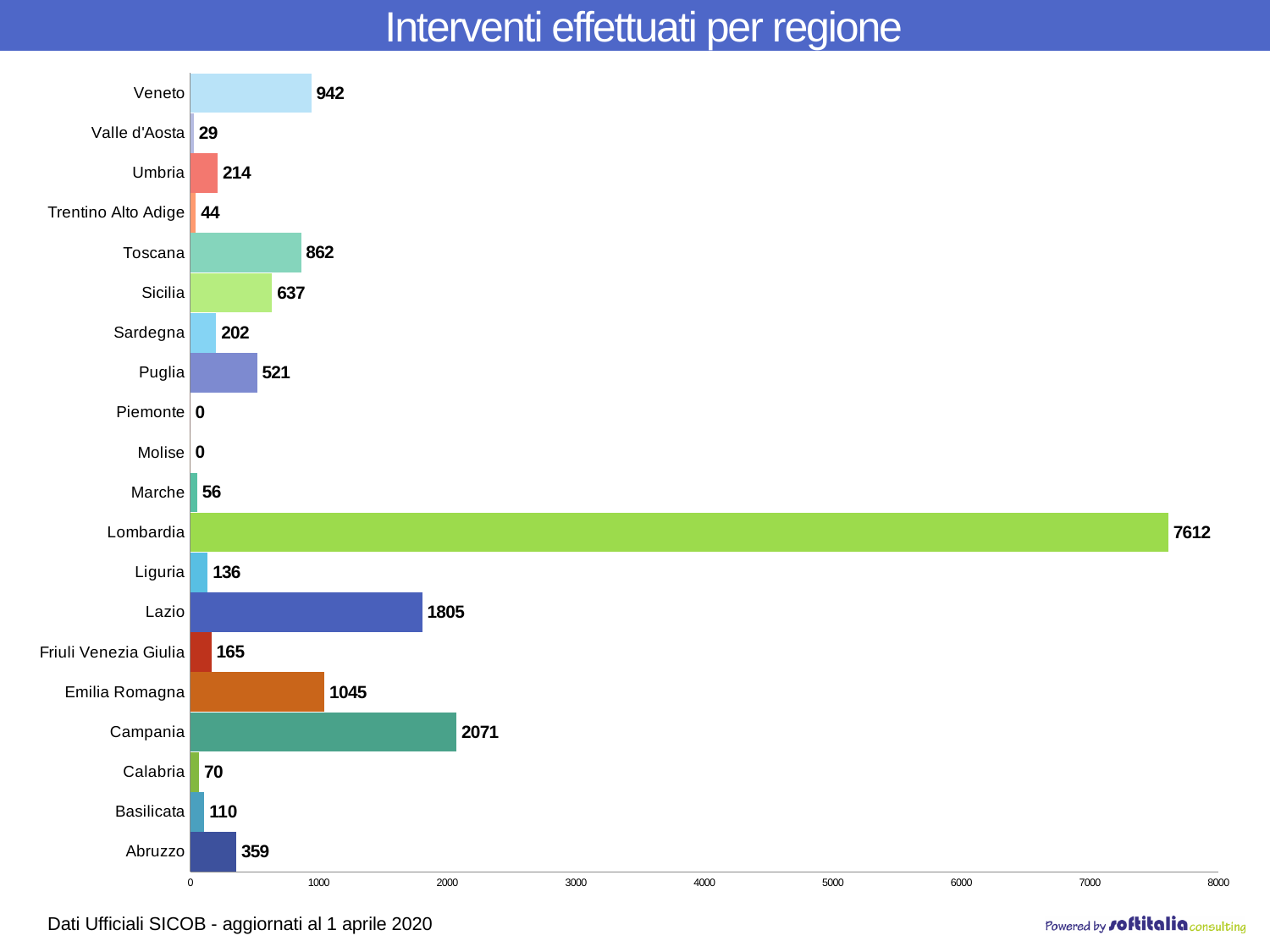
Which is larger, the value for Sicilia or the value for Puglia? Sicilia How many regions show a value of 0? 2 What is the difference between the values for Veneto and Toscana? 80 Which region has the highest value? Lombardia Is the value for Campania greater or less than 2000? greater Which is larger, the value for Umbria or the value for Sardegna? Umbria What is the value for Lombardia? 7612 What is the value for Trentino Alto Adige? 44 What is the difference between the values for Lazio and Emilia Romagna? 760 What is the value for Campania? 2071 How many regions are shown on the chart? 20 What kind of chart is shown on the slide? Bar chart